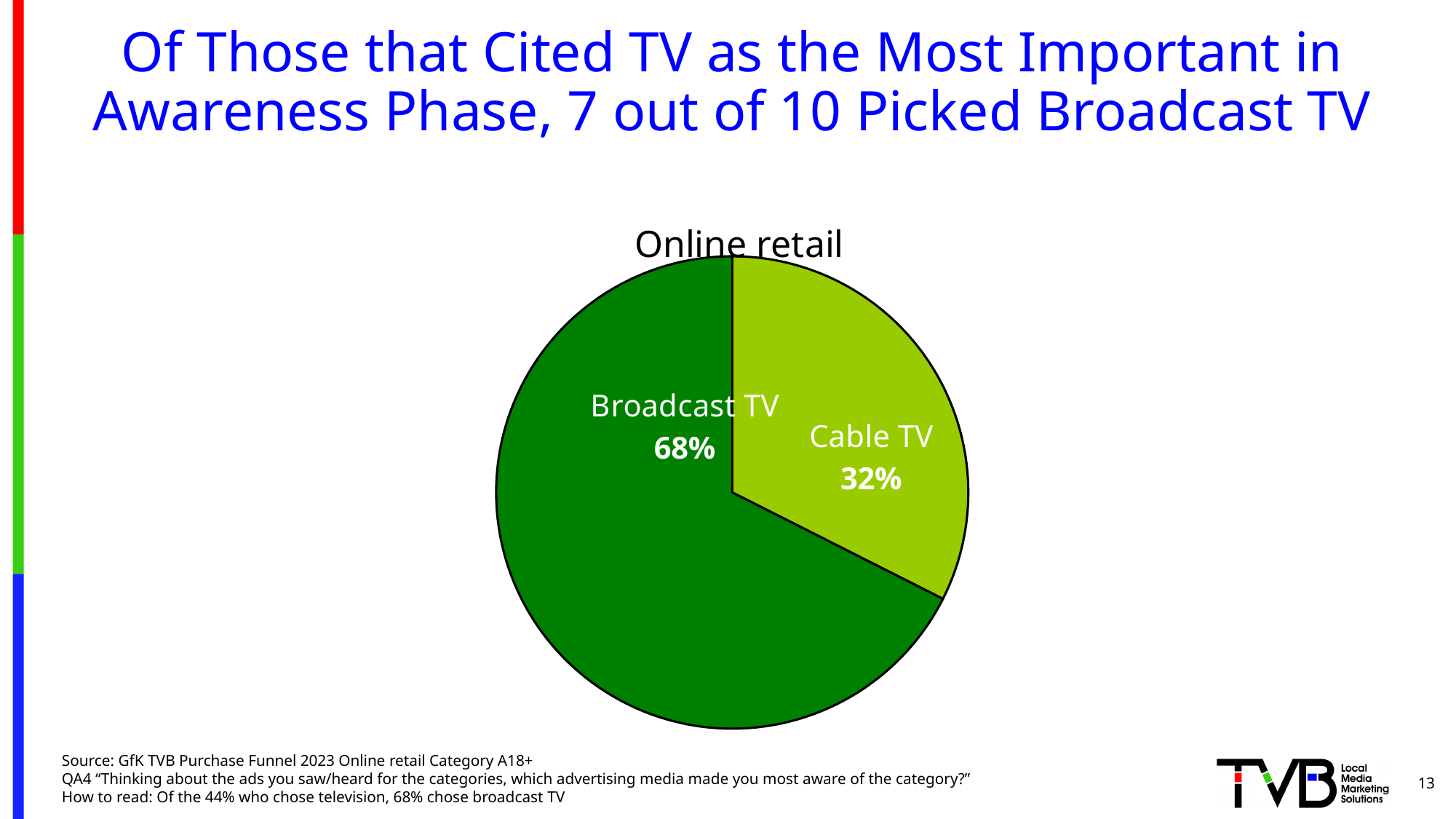
Which slice of the pie is the smallest? Cable TV Is the value for Cable TV greater or less than 50%? less What share of the pie does Broadcast TV hold? 68% How many slices does the pie chart have? 2 What is the difference in percentage points between Broadcast TV and Cable TV? 36 What is the title of the chart? Online retail Which is larger, the Broadcast TV slice or the Cable TV slice? Broadcast TV Which slice of the pie is the largest? Broadcast TV What share of the pie does Cable TV hold? 32% What kind of chart is shown on the slide? Pie chart What colour is the Cable TV slice? Light green